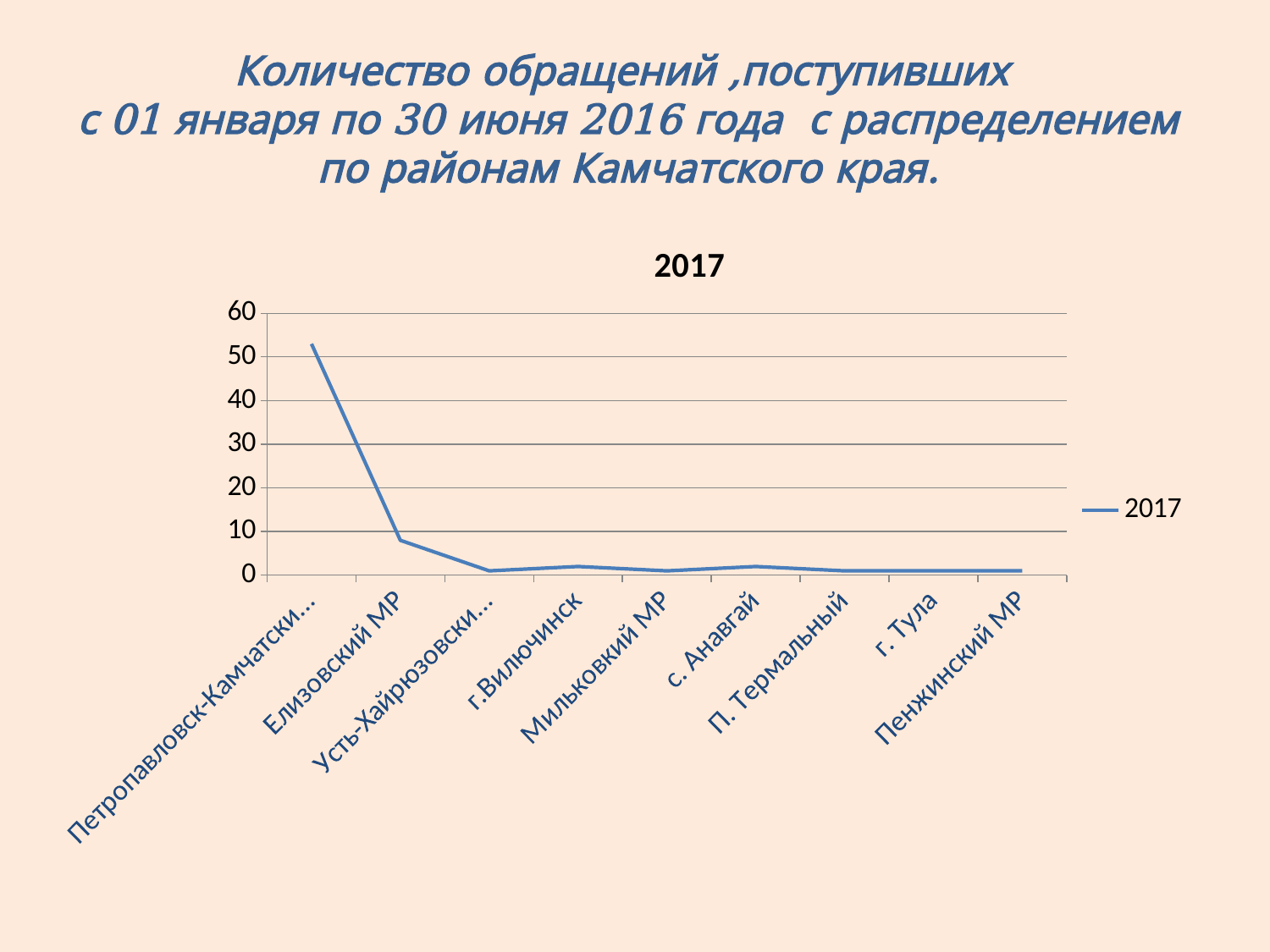
What is the name of the series shown in the chart legend? 2017 What is the title shown above the chart? 2017 Do the values generally rise or fall moving from left to right along the x axis? fall Which is larger, the value for Елизовский МР or the value for Пенжинский МР? Елизовский МР Is the value for Елизовский МР greater or less than 10? less Is the value for Петропавловск-Камчатски... greater or less than 40? greater What kind of chart is shown on the slide? line chart Which is larger, the value for Петропавловск-Камчатски... or the value for Елизовский МР? Петропавловск-Камчатски... Which category has the highest value in the chart? Петропавловск-Камчатски... Is the value for г.Вилючинск greater or less than 10? less How many series does the chart legend list? 1 How many categories are plotted along the x axis of the chart? 9